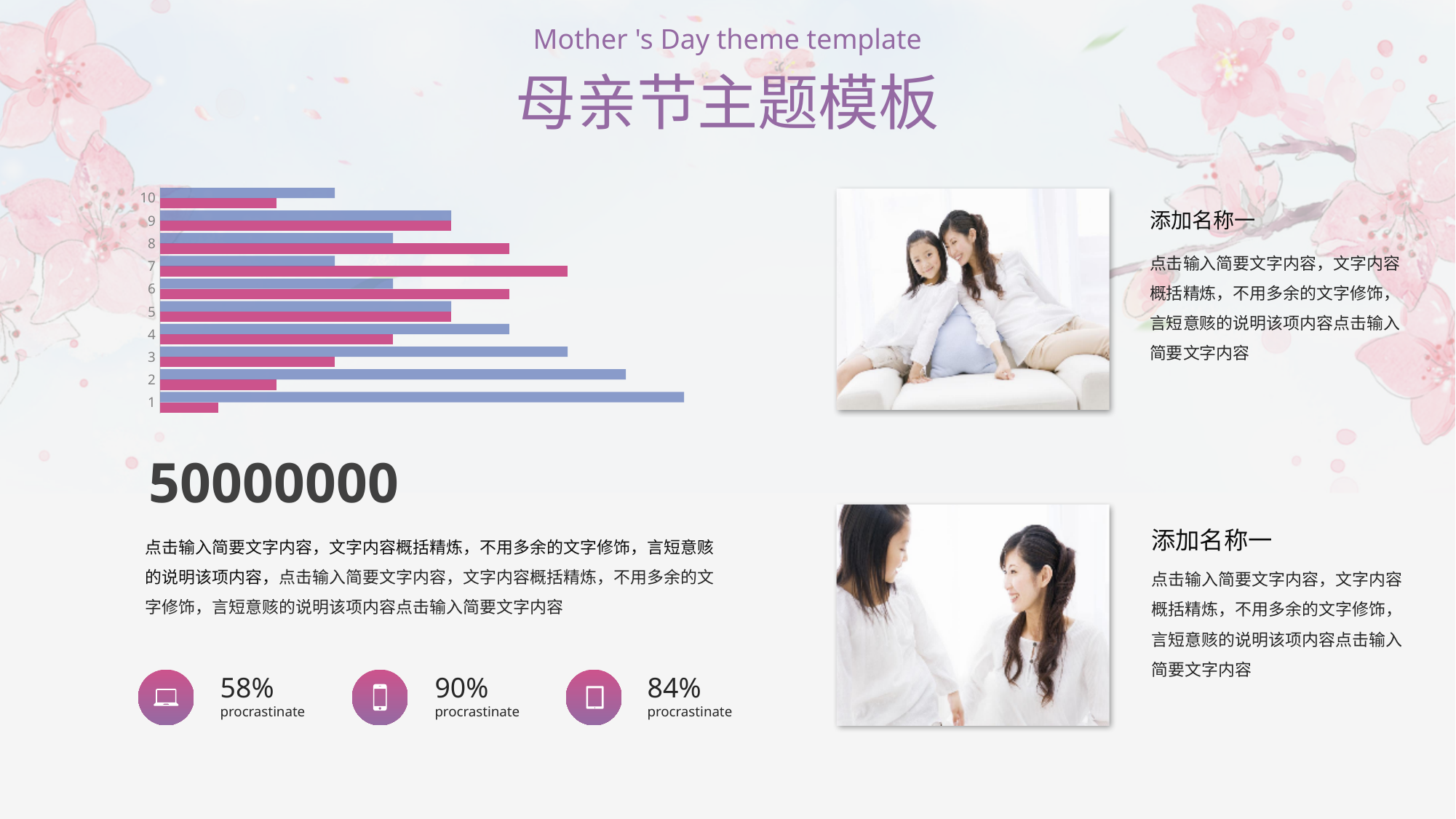
Which category has the shortest pink bar in the bar chart? 1 How many categories are shown on the vertical axis of the bar chart? 10 Which category has the longest blue bar in the bar chart? 1 What kind of chart is shown on the left of the slide? bar chart What two colours are used for the bars in the chart? blue and pink Are the bars in the chart drawn horizontally or vertically? horizontally For category 7, which bar is longer, the blue one or the pink one? pink How many data series (bar colours) are plotted in the bar chart? 2 For category 8, which bar is longer, the blue one or the pink one? pink For category 2, which bar is longer, the blue one or the pink one? blue Which category has the longest pink bar in the bar chart? 7